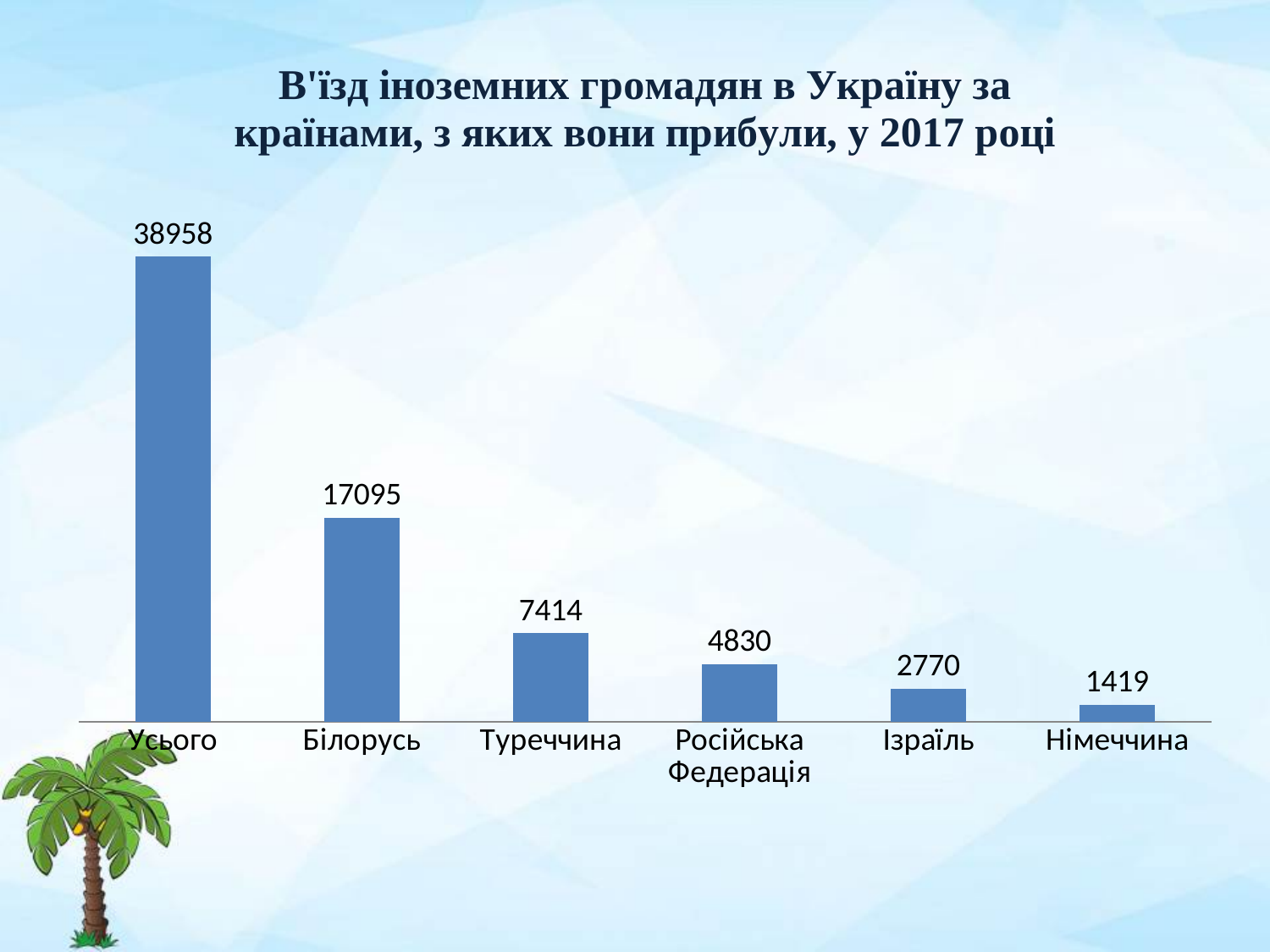
What is the value for Російська Федерація? 4830 Which category has the highest value? Усього What is the value for Білорусь? 17095 Which is larger, the value for Ізраїль or the value for Німеччина? Ізраїль What is the value for Туреччина? 7414 How many categories are shown on the x axis? 6 What kind of chart is shown on the slide? Bar chart What is the value for Ізраїль? 2770 What is the value for Німеччина? 1419 Which category has the lowest value? Німеччина Do the values rise or fall from left to right along the x axis? Fall What is the difference between the values for Білорусь and Туреччина? 9681